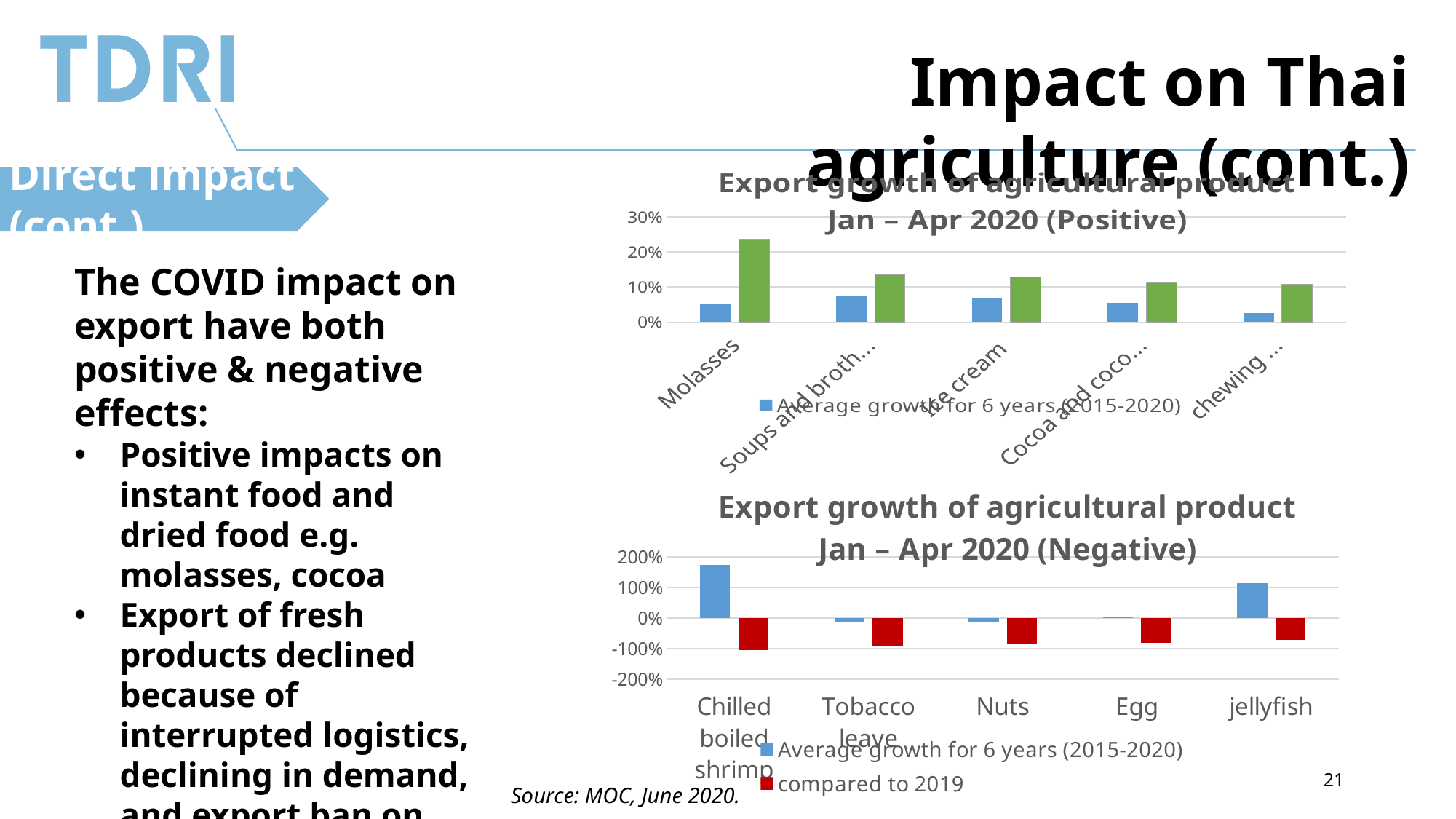
In the 'Export growth of agricultural product Jan – Apr 2020 (Positive)' chart, which category has the highest green bar? Molasses In the 'Export growth of agricultural product Jan – Apr 2020 (Positive)' chart, is the green bar for Molasses greater or less than 20%? greater What kind of chart is the 'Export growth of agricultural product Jan – Apr 2020 (Positive)' chart? bar chart How many categories are shown in the 'Export growth of agricultural product Jan – Apr 2020 (Negative)' chart? 5 In the 'Export growth of agricultural product Jan – Apr 2020 (Negative)' chart, which is larger: the 'Average growth for 6 years (2015-2020)' value for Chilled boiled shrimp or for jellyfish? Chilled boiled shrimp In the 'Export growth of agricultural product Jan – Apr 2020 (Negative)' chart, is the 'Average growth for 6 years (2015-2020)' value for Chilled boiled shrimp greater or less than 100%? greater In the 'Export growth of agricultural product Jan – Apr 2020 (Negative)' chart, which category has the highest 'Average growth for 6 years (2015-2020)' value? Chilled boiled shrimp In the 'Export growth of agricultural product Jan – Apr 2020 (Negative)' chart, which series is shown in red? compared to 2019 In the 'Export growth of agricultural product Jan – Apr 2020 (Positive)' chart, do the green bars generally rise or fall from left to right? fall In the 'Export growth of agricultural product Jan – Apr 2020 (Positive)' chart, is the green bar for Ice cream greater or less than 10%? greater How many series does the legend of the 'Export growth of agricultural product Jan – Apr 2020 (Negative)' chart list? 2